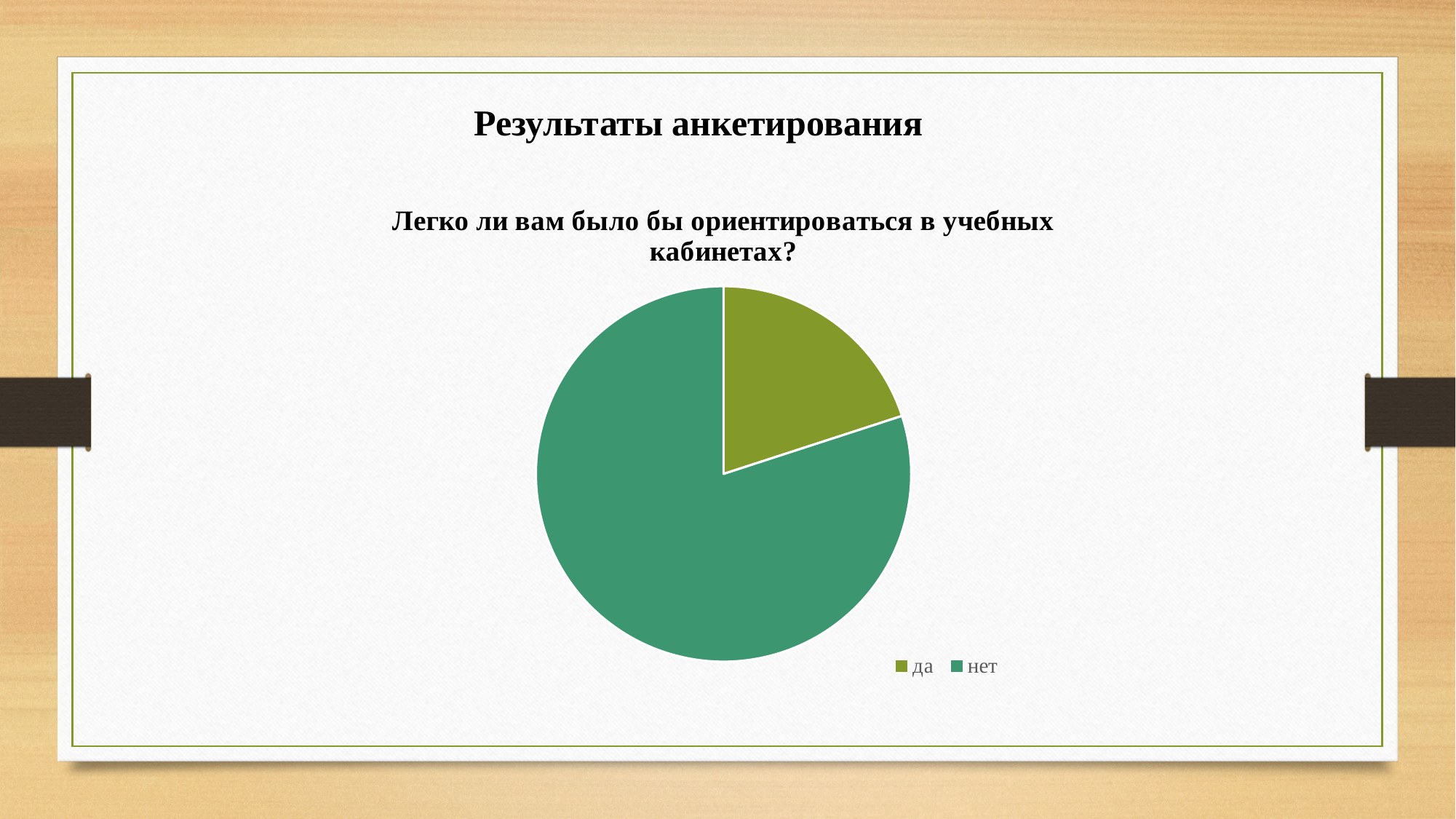
Which legend entry is shown in the olive green colour in the pie chart? да Which category has the smallest slice in the pie chart? да How many entries does the legend of the pie chart list? 2 What is the title of the pie chart? Легко ли вам было бы ориентироваться в учебных кабинетах? Which category has the largest slice in the pie chart? нет Which slice is larger in the pie chart, "да" or "нет"? нет What kind of chart is shown on the slide? pie chart How many slices does the pie chart have? 2